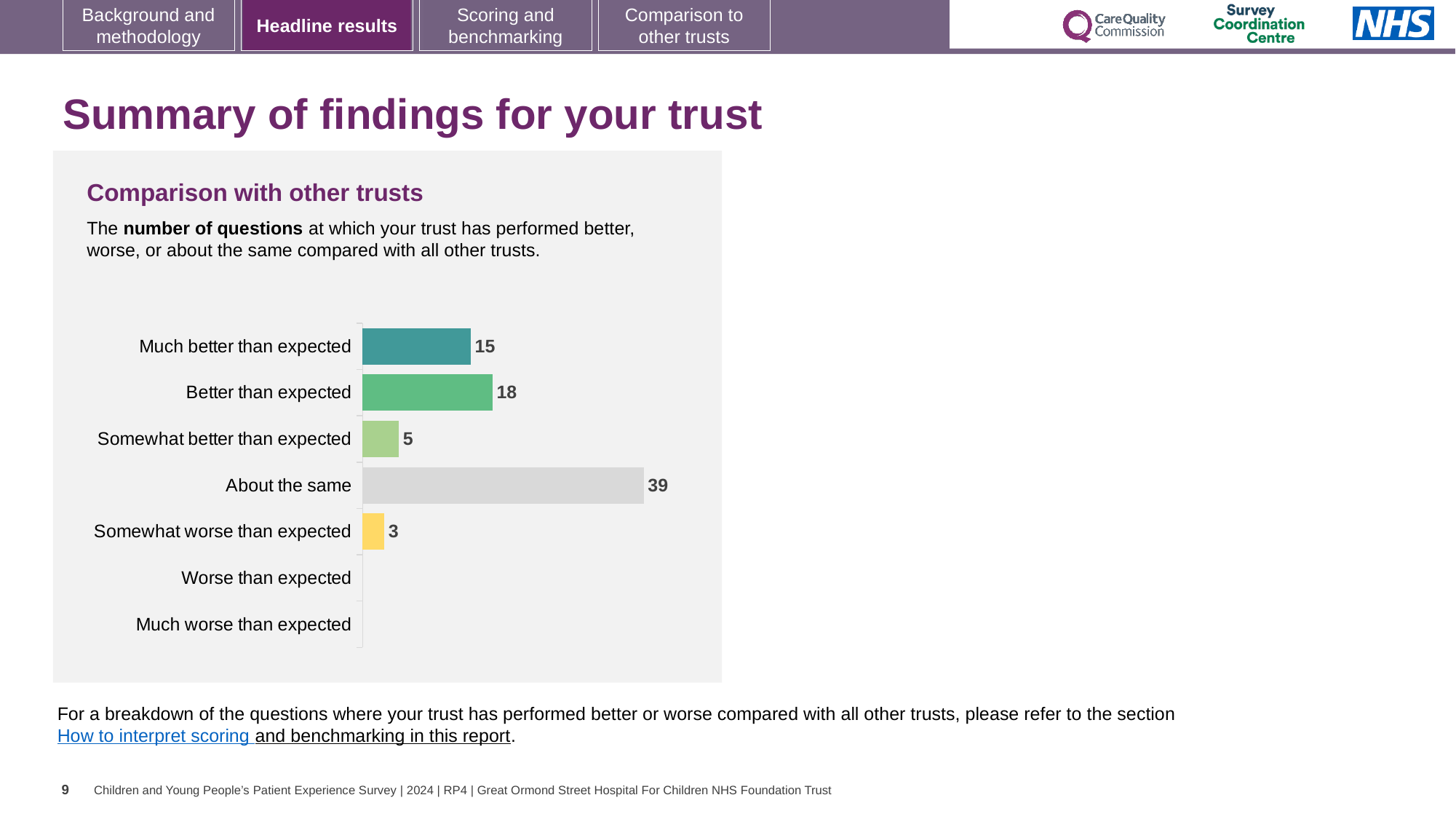
What is the difference between 'Better than expected' and 'Much better than expected'? 3 What kind of chart is shown on the slide? Bar chart Which category has the highest number of questions? About the same What is the difference between 'About the same' and 'Somewhat better than expected'? 34 What is the total number of questions across the three 'better than expected' categories? 38 What is the value for 'Much better than expected'? 15 How many questions are in the 'About the same' category? 39 Among the categories with a visible bar, which has the lowest value? Somewhat worse than expected What is the title of the chart? Comparison with other trusts How many categories are listed on the chart? 7 Which is larger: 'Better than expected' or 'Somewhat better than expected'? Better than expected What is the value for 'Somewhat worse than expected'? 3